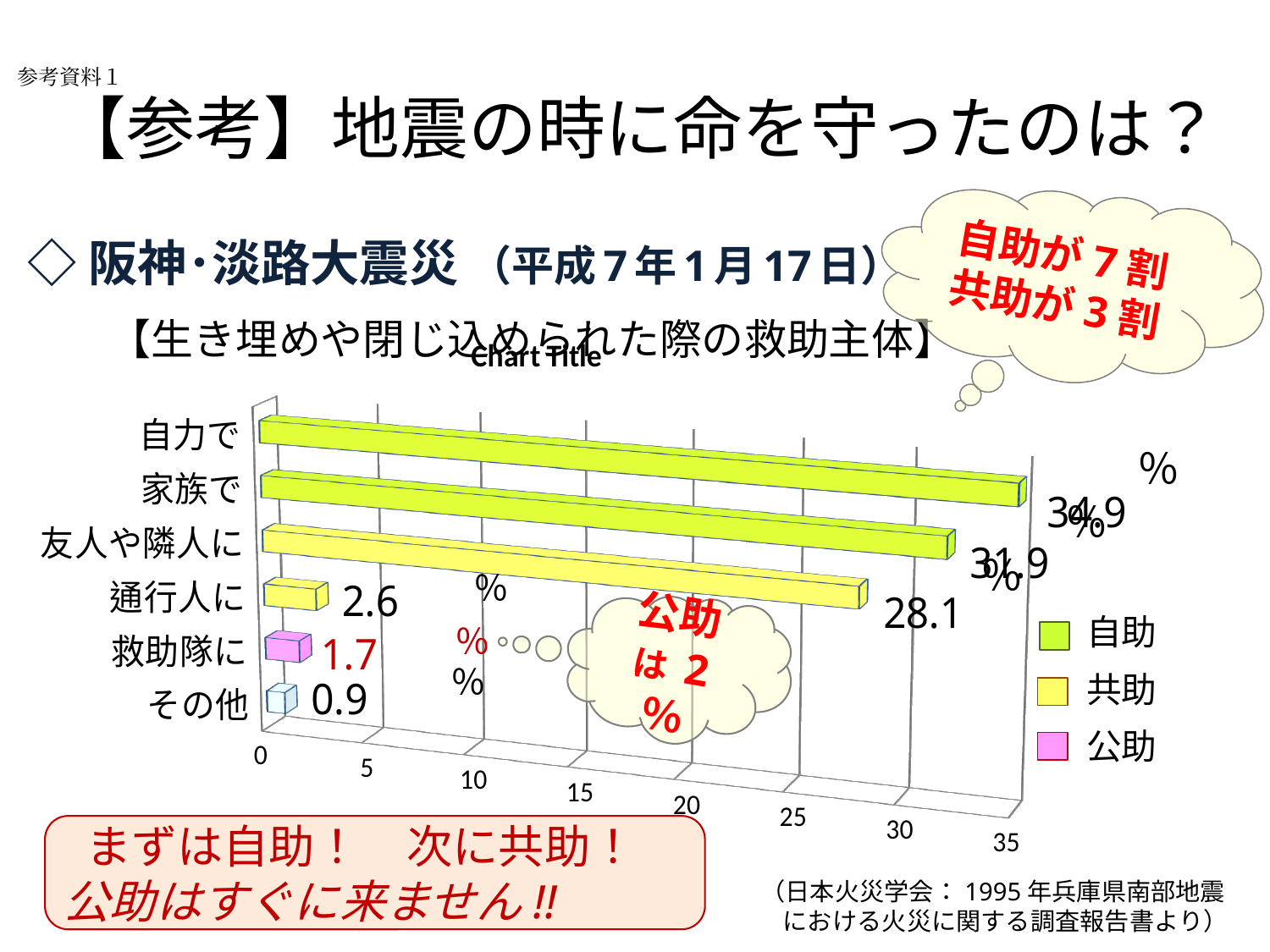
What kind of chart is shown? bar chart What value is shown for 救助隊に? 1.7 What value is shown for 友人や隣人に? 28.1 What value is shown for 家族で? 31.9 Which category has the lowest value? その他 What is the difference between the values for 自力で and 家族で? 3.0 Is the value for 友人や隣人に greater or less than 25? greater Which is larger, the value for 通行人に or the value for 救助隊に? 通行人に Which category has the highest value? 自力で What value is shown for 自力で? 34.9 How many entries does the legend list? 3 How many categories are shown on the chart? 6